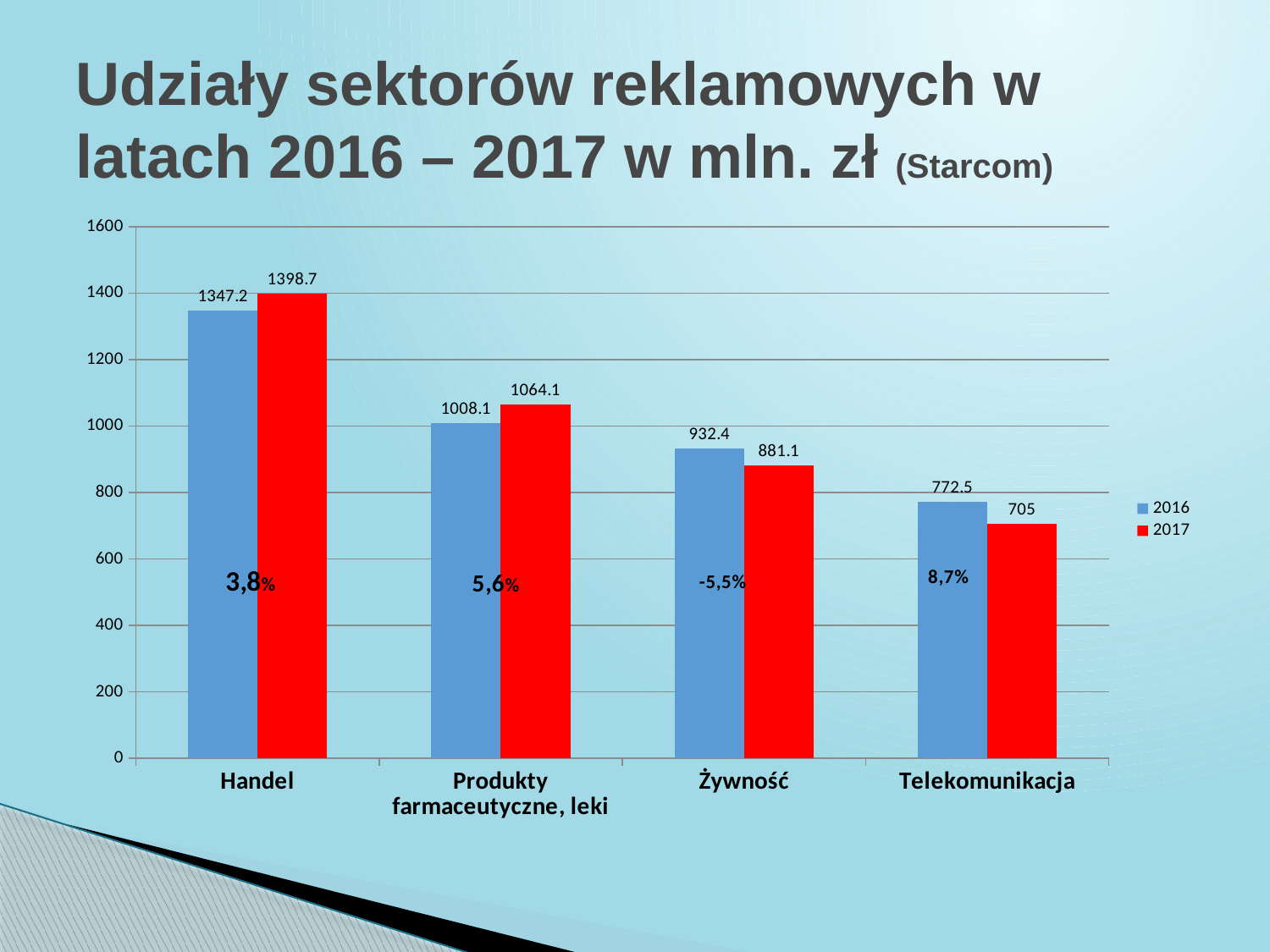
What is the 2017 value for Produkty farmaceutyczne, leki? 1064.1 Which category has the highest 2017 value? Handel What is the difference between the 2017 and 2016 values for Handel? 51.5 What is the 2017 value for Telekomunikacja? 705 Which is larger for Żywność, the 2016 value or the 2017 value? 2016 Which category has the lowest 2016 value? Telekomunikacja What kind of chart is shown on the slide? bar chart What is the difference between the 2016 and 2017 values for Telekomunikacja? 67.5 What percentage change label is shown for Żywność? -5,5% How many categories are shown on the x axis? 4 How many series does the legend list? 2 What is the 2016 value for Handel? 1347.2